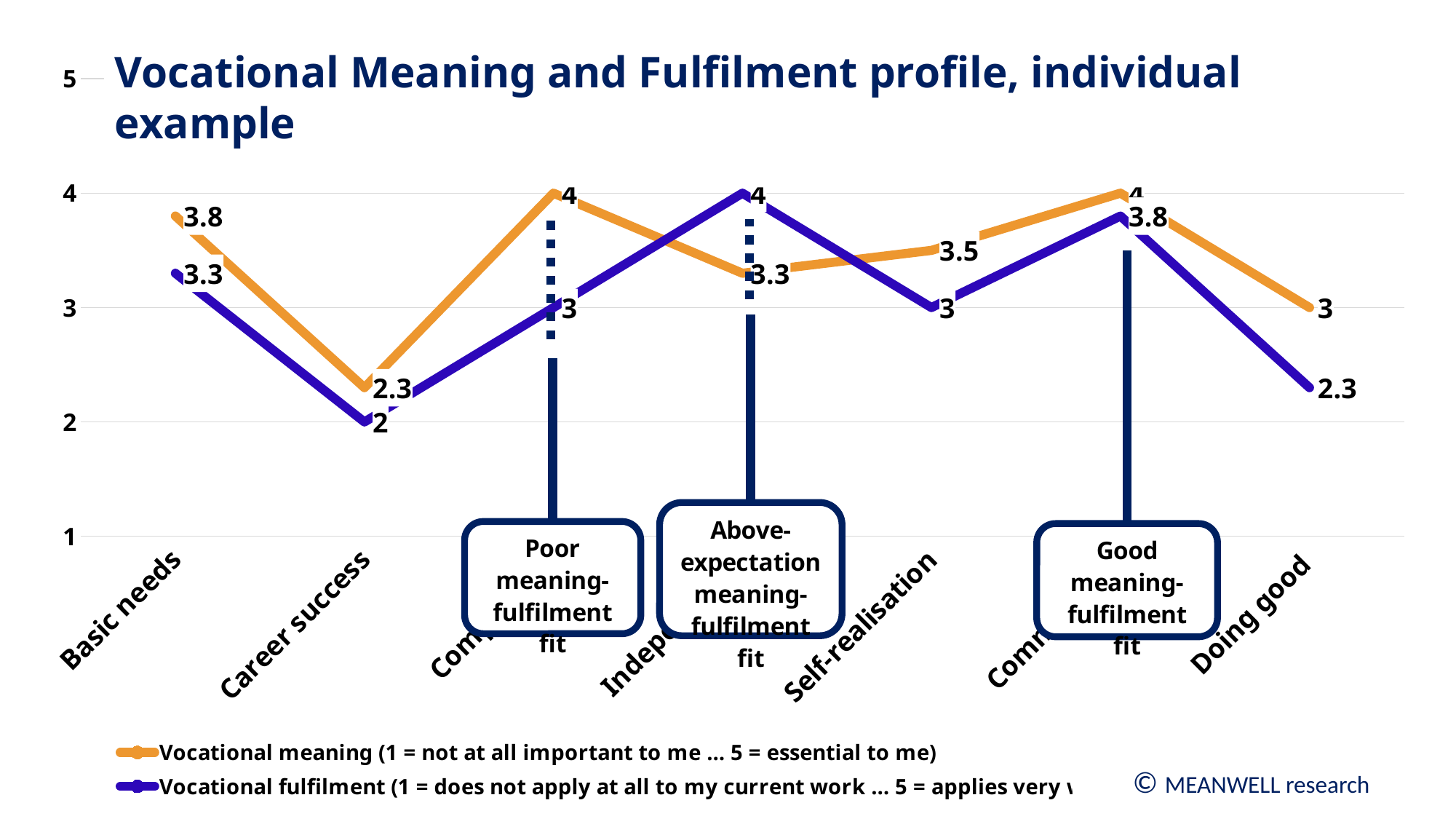
What is the difference between the Vocational meaning and Vocational fulfilment values for Basic needs? 0.5 What colour is the Vocational meaning line? Orange What kind of chart is shown on the slide? Line chart What is the Vocational fulfilment value for Basic needs? 3.3 What is the Vocational meaning value for Self-realisation? 3.5 What is the Vocational meaning value for Basic needs? 3.8 What is the Vocational meaning value for Career success? 2.3 What is the Vocational fulfilment value for Career success? 2 Which category has the lowest Vocational fulfilment value? Career success What is the Vocational fulfilment value for Doing good? 2.3 For Doing good, which series has the larger value, Vocational meaning or Vocational fulfilment? Vocational meaning How many series does the legend list? 2